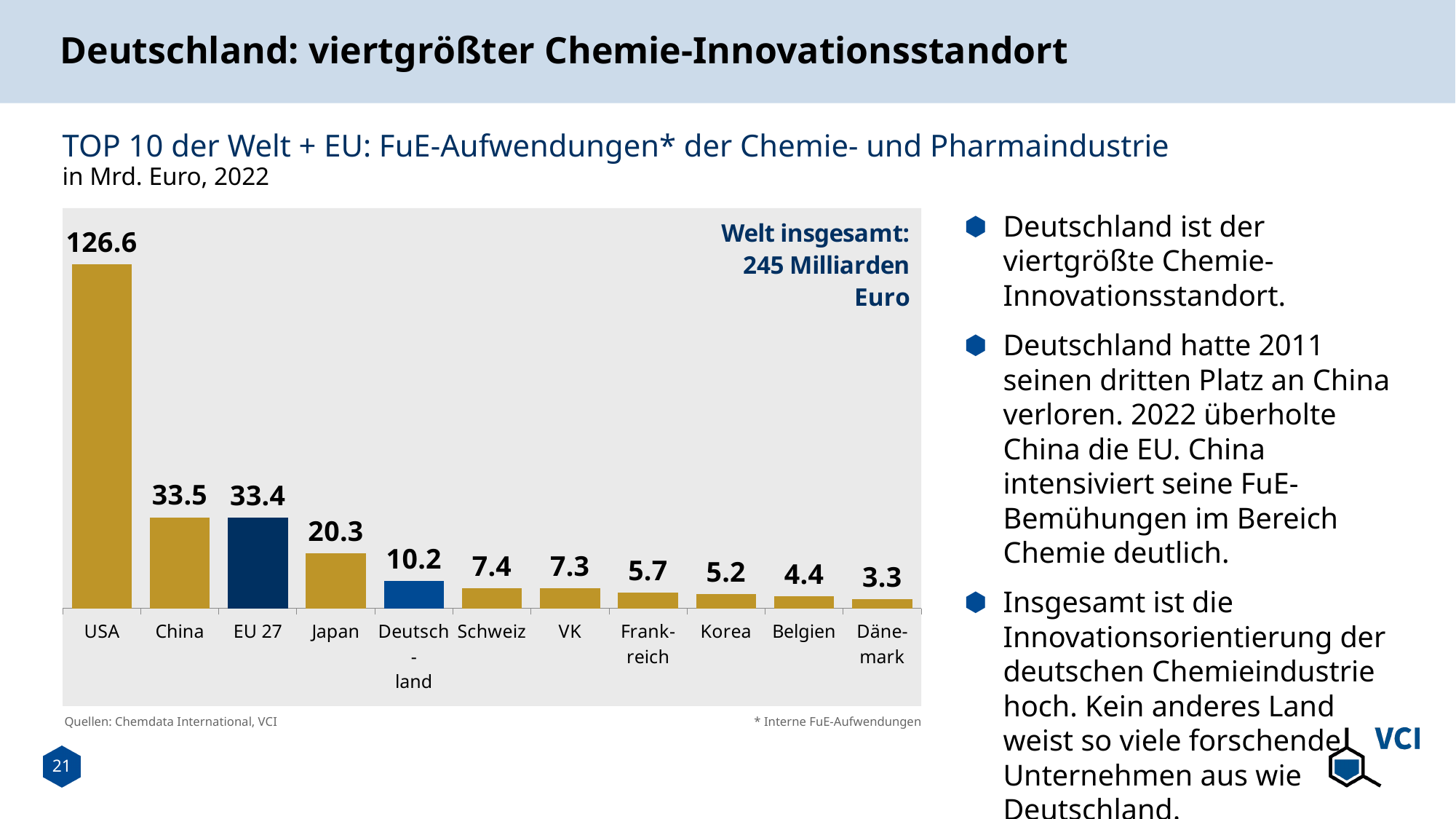
What world total is stated in the chart? 245 Milliarden Euro What kind of chart is shown on the slide? bar chart What is the value for Japan? 20.3 Which category has the lowest value? Dänemark Which is larger, the value for Schweiz or the value for Frankreich? Schweiz Which category has the highest value? USA What is the difference between the values for Japan and Deutschland? 10.1 What is the value for USA? 126.6 How many categories are shown in the chart? 11 What is the difference between the values for USA and China? 93.1 What is the value for Deutschland? 10.2 Do the values rise or fall from left to right along the x axis? fall